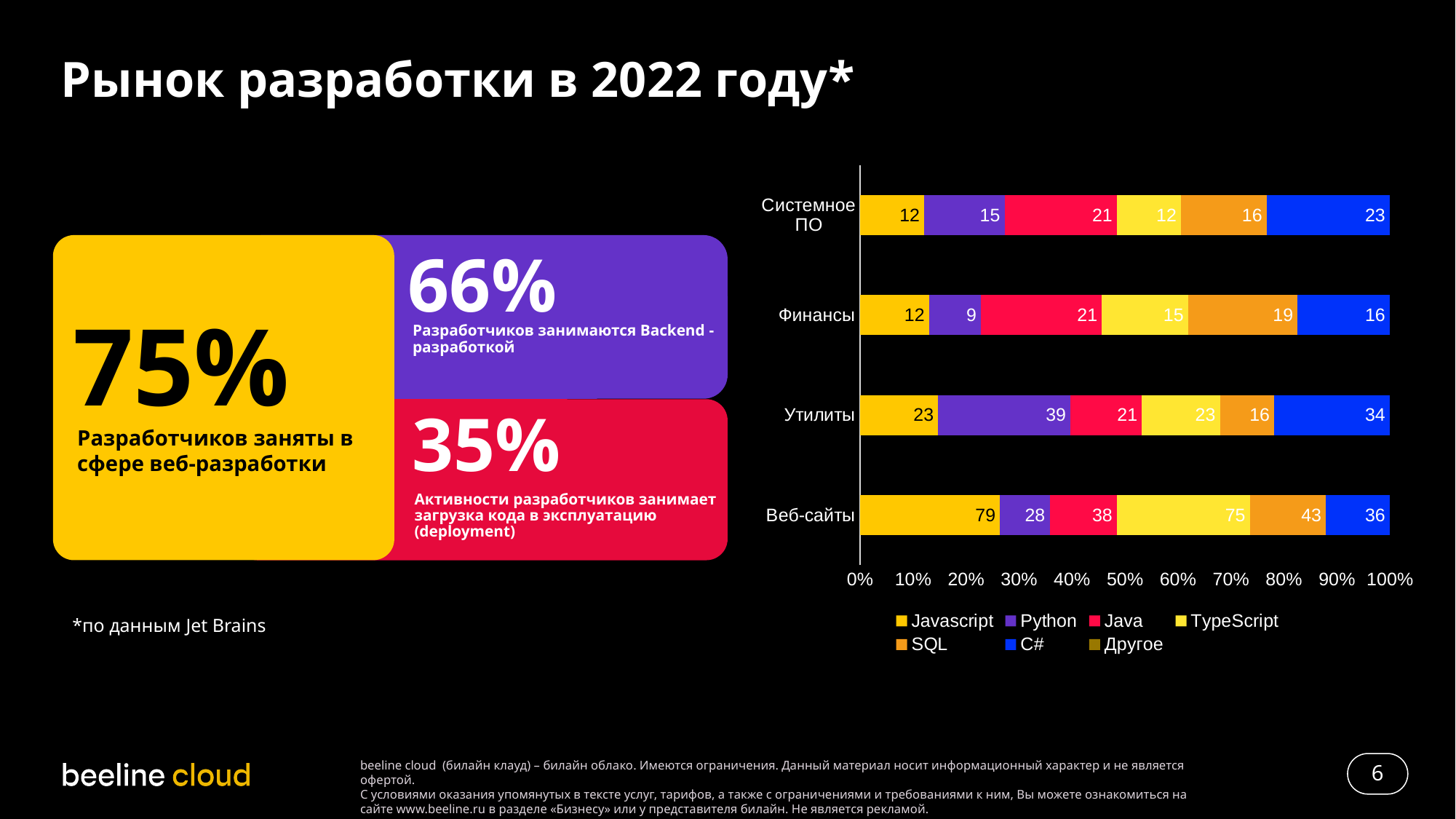
What is the SQL value for Системное ПО? 16 What is the Javascript value for Веб-сайты? 79 What is the difference between the Java value for Веб-сайты and the Java value for Финансы? 17 How many series does the legend list? 7 What colour represents C# in the legend? Blue What is the C# value for Утилиты? 34 Which category has the highest Javascript value? Веб-сайты What is the Python value for Финансы? 9 Which category has the lowest Python value? Финансы How many categories are shown on the chart? 4 Which is larger: the TypeScript value for Утилиты or the TypeScript value for Финансы? Утилиты What kind of chart is shown on the slide? Stacked bar chart